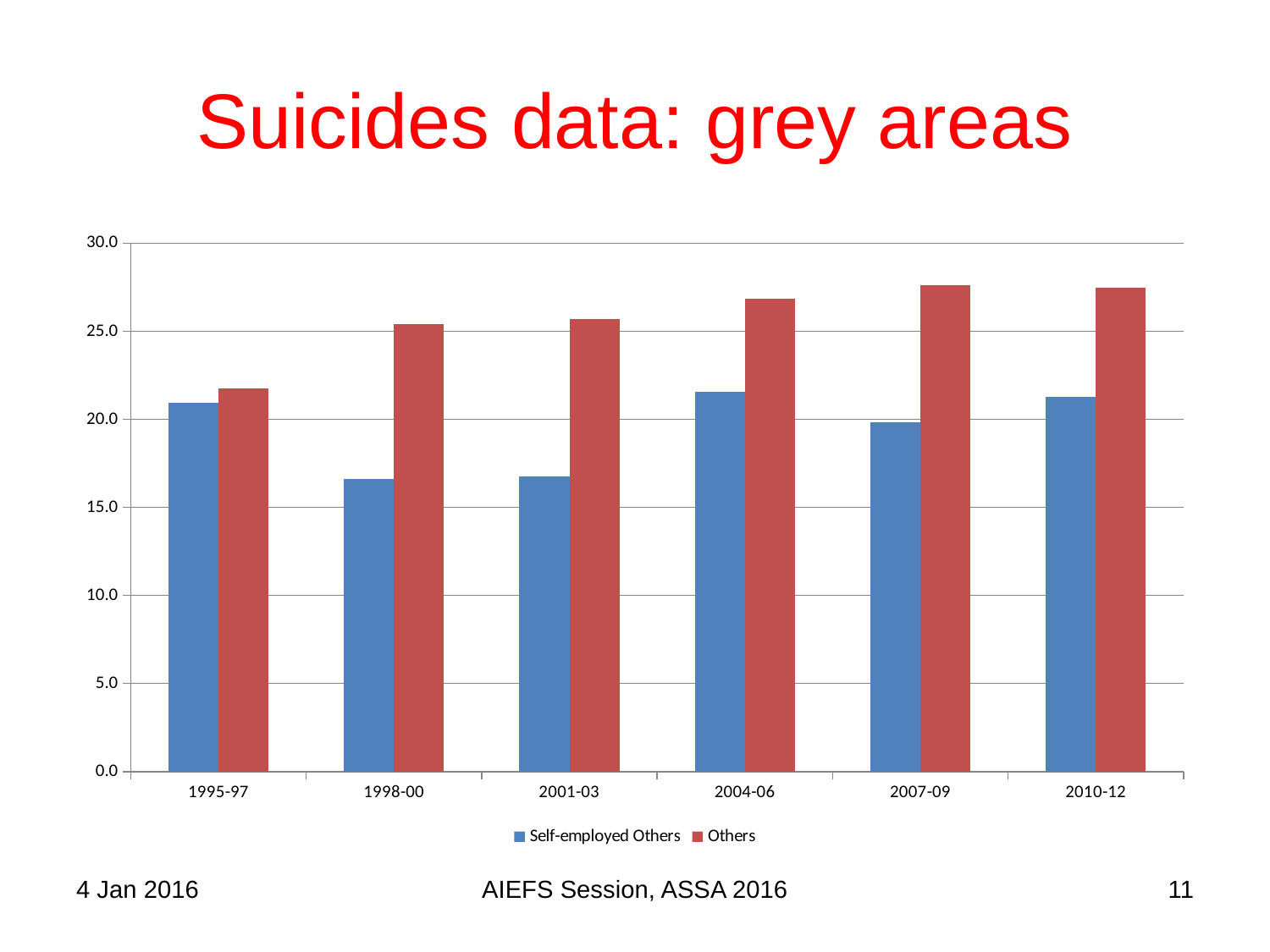
What is the title of the slide containing the chart? Suicides data: grey areas In 1998-00, which is larger: Self-employed Others or Others? Others Is the value for Self-employed Others in 1998-00 greater or less than 20.0? less Is the value for Others in 1995-97 greater or less than 25.0? less What kind of chart is shown on the slide? bar chart Which series does the legend list first? Self-employed Others How many time periods are shown on the x axis? 6 Is the value for Others in 2007-09 greater or less than 25.0? greater In which period is the value for Others lowest? 1995-97 For Self-employed Others, which is larger: 1995-97 or 1998-00? 1995-97 How many series does the legend list? 2